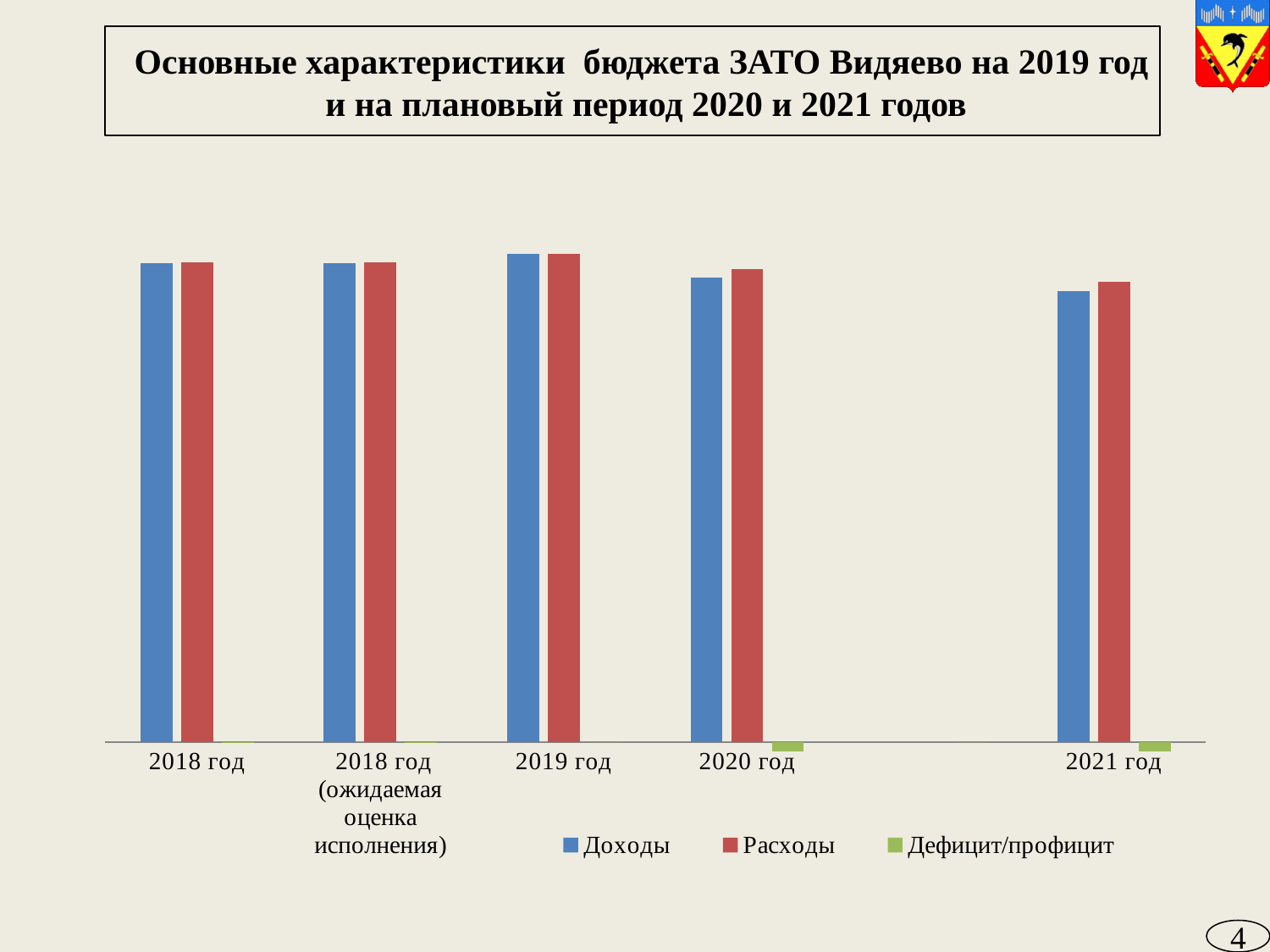
In 2020 год, which is larger: Доходы or Расходы? Расходы Which category has the lowest value for Доходы? 2021 год Which colour represents the Расходы series? red Which category has the highest value for Расходы? 2019 год How many series does the legend list? 3 What kind of chart is shown on the slide? bar chart What is the name of the series shown in green in the legend? Дефицит/профицит In 2021 год, which is larger: Доходы or Расходы? Расходы Which category has the highest value for Доходы? 2019 год Do the values for Доходы rise or fall from 2019 год to 2021 год? fall Which category has the lowest value for Расходы? 2021 год How many categories are shown on the x axis? 5